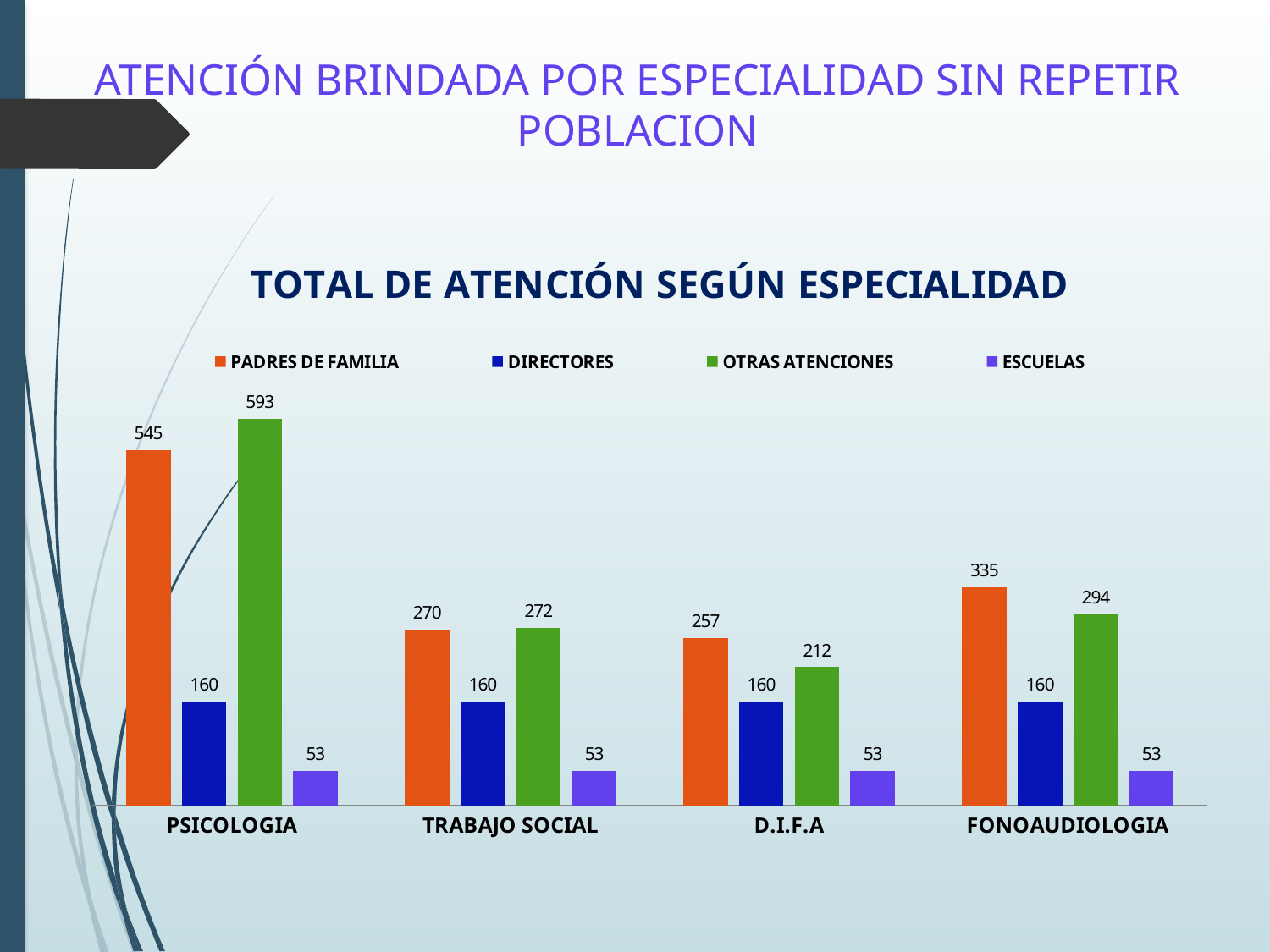
What is the value for PADRES DE FAMILIA in the PSICOLOGIA category? 545 Which category has the highest value for OTRAS ATENCIONES? PSICOLOGIA What kind of chart is shown on the slide? Bar chart What is the title of the chart? TOTAL DE ATENCIÓN SEGÚN ESPECIALIDAD What is the value for ESCUELAS in every category? 53 Which category has the lowest value for PADRES DE FAMILIA? D.I.F.A What is the value for OTRAS ATENCIONES in the FONOAUDIOLOGIA category? 294 What is the value for DIRECTORES in the D.I.F.A category? 160 What is the difference between the OTRAS ATENCIONES value and the PADRES DE FAMILIA value in the PSICOLOGIA category? 48 Which is larger in the TRABAJO SOCIAL category: PADRES DE FAMILIA or OTRAS ATENCIONES? OTRAS ATENCIONES How many series does the legend list? 4 How many categories are shown on the x axis? 4